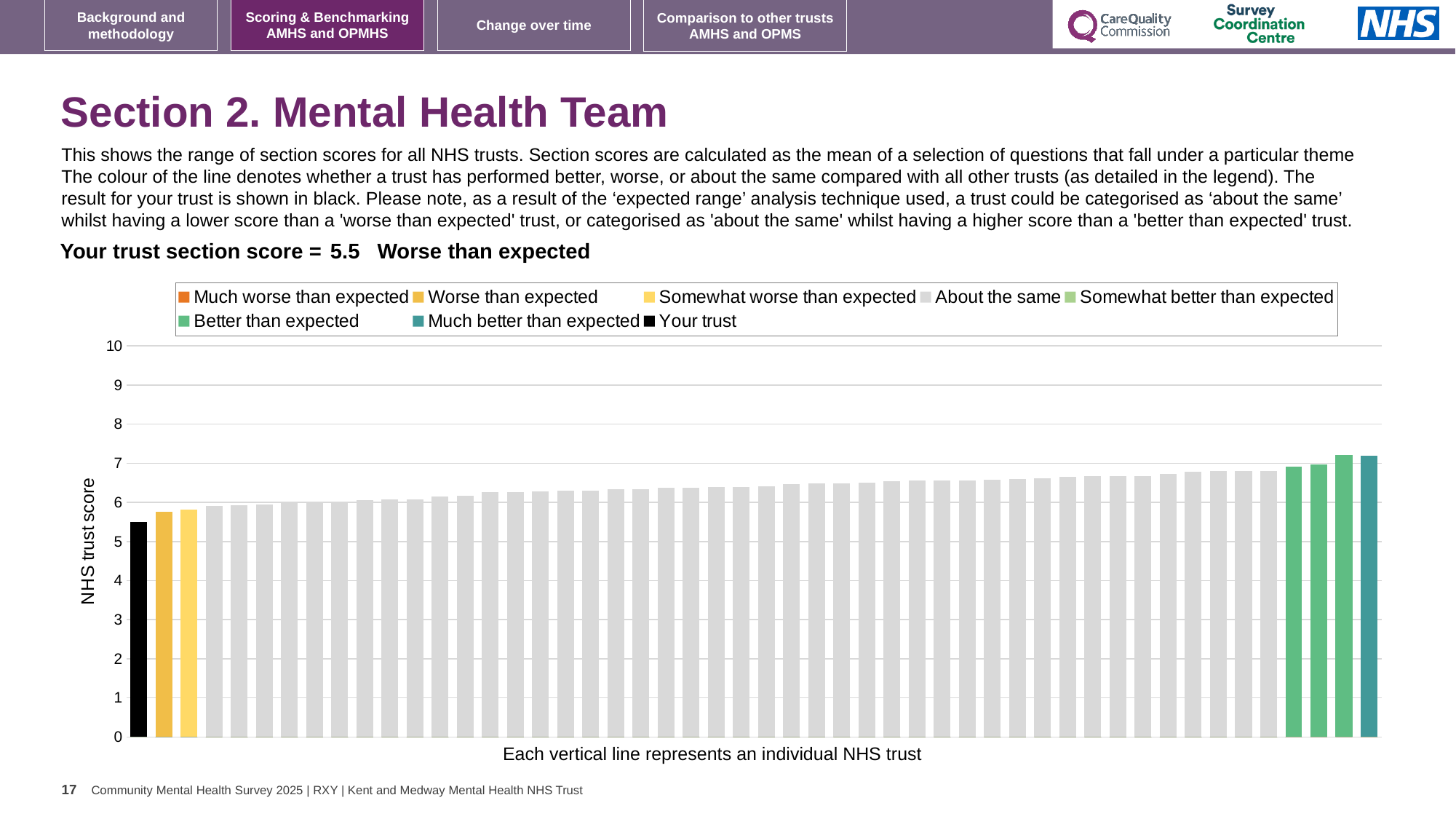
How many entries does the chart legend list? 8 What is the label on the y axis of the chart? NHS trust score Is the value for your trust greater or less than 6? less What colour is the bar representing your trust? black What kind of chart is shown on the slide? bar chart Which performance category is your trust placed in for this section? Worse than expected Do the bar values rise or fall from left to right along the x axis? rise How many bars are coloured as 'Worse than expected' (yellow)? 1 Is the value of the tallest bar greater or less than 8? less What is the section score for your trust shown on the slide? 5.5 Which trust has the lowest score in the chart? Your trust Is the value of the shortest bar greater or less than 5? greater